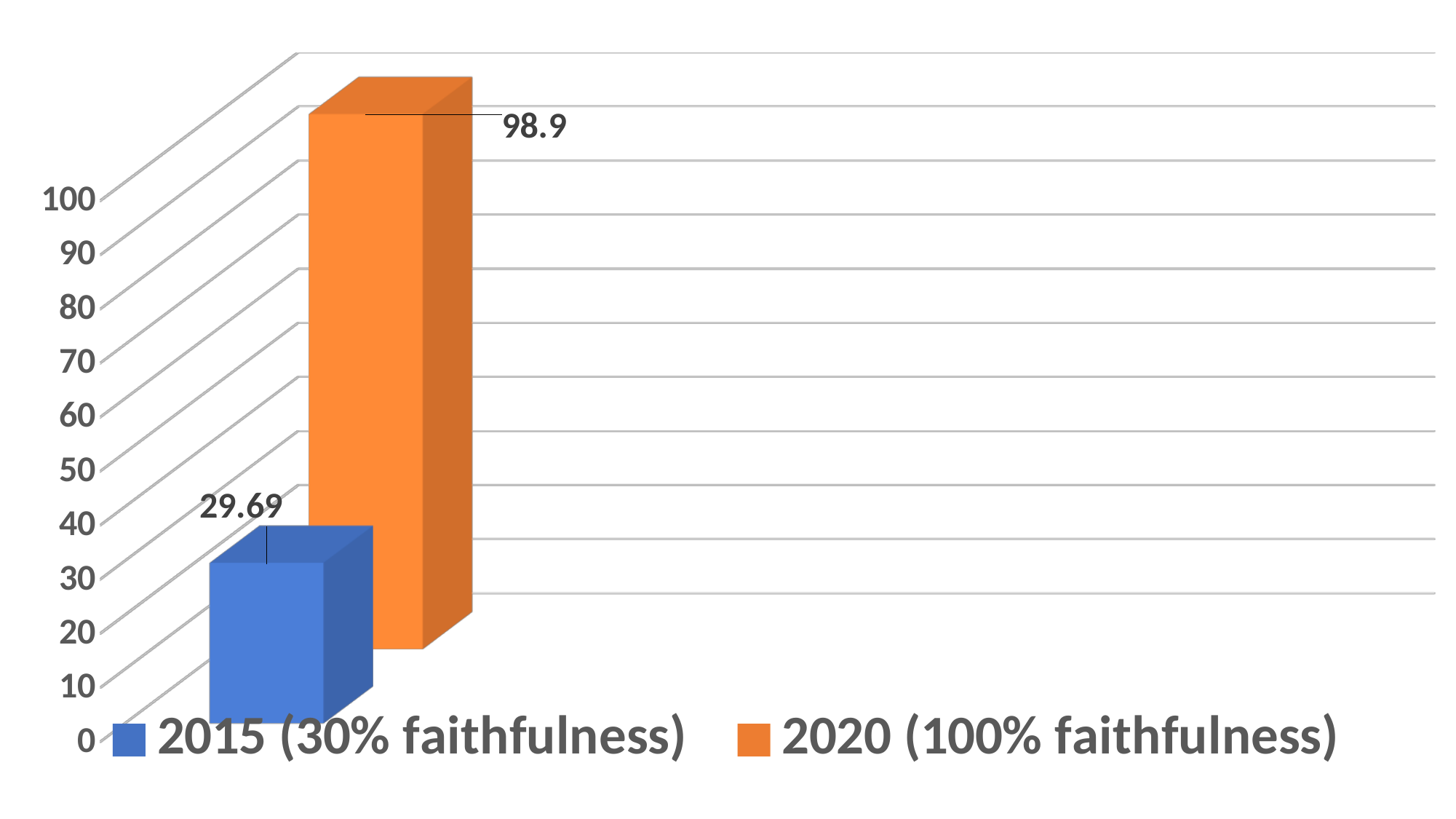
Which is larger, the value for 2015 (30% faithfulness) or the value for 2020 (100% faithfulness)? 2020 (100% faithfulness) Which series has the lowest value? 2015 (30% faithfulness) What is the value for 2015 (30% faithfulness)? 29.69 What colour is the bar for 2020 (100% faithfulness)? orange Which series has the highest value? 2020 (100% faithfulness) What is the highest value shown on the vertical axis? 100 Is the value for 2015 (30% faithfulness) greater or less than 50? less What is the value for 2020 (100% faithfulness)? 98.9 How many series does the legend list? 2 Is the value for 2020 (100% faithfulness) greater or less than 90? greater What is the difference between the 2020 (100% faithfulness) value and the 2015 (30% faithfulness) value? 69.21 What kind of chart is shown on the slide? bar chart